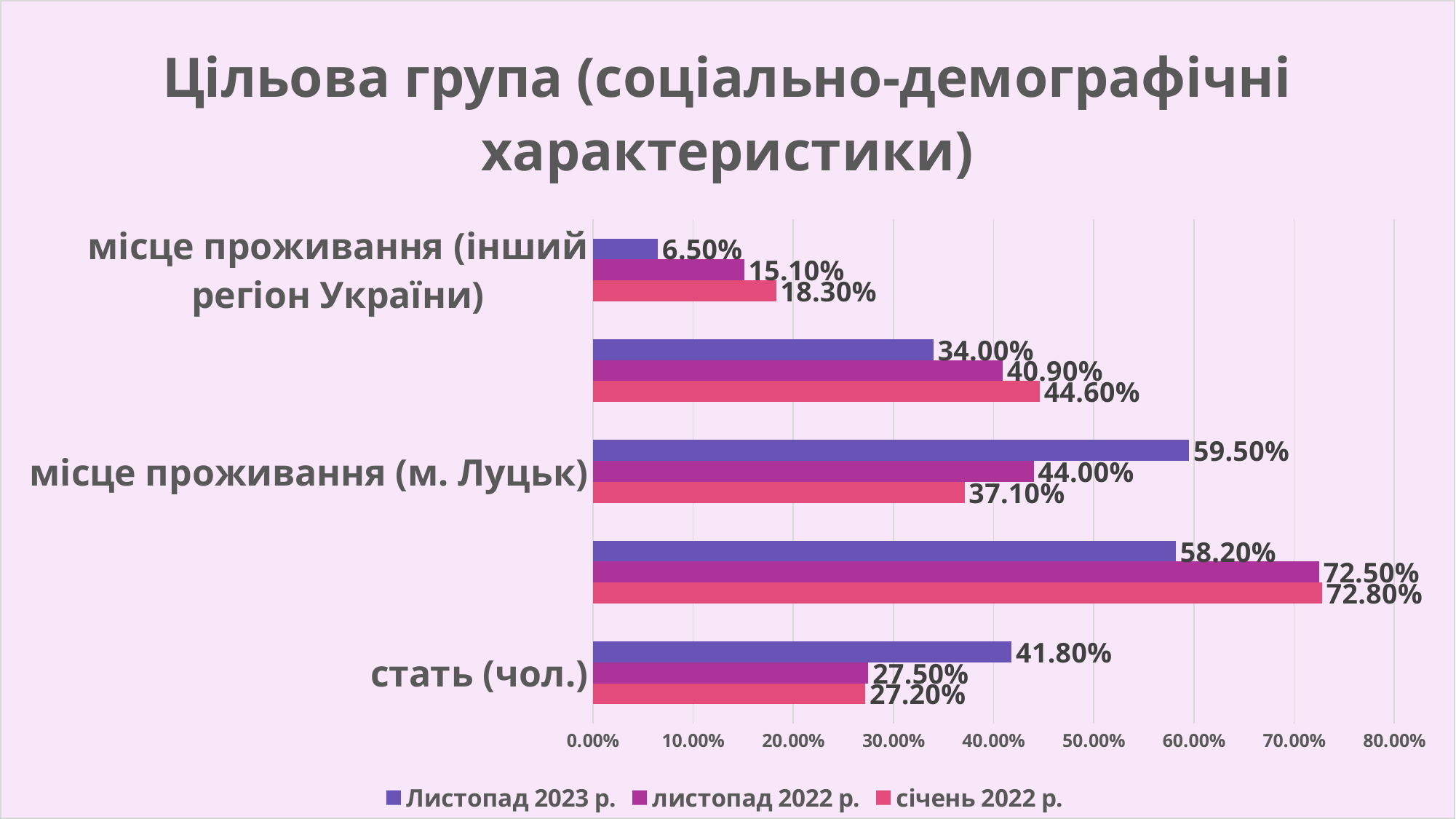
What is the value for 'стать (чол.)' in the 'Листопад 2023 р.' series? 41.80% Which category has the highest value in the 'Листопад 2023 р.' series? місце проживання (м. Луцьк) What is the value for 'місце проживання (інший регіон України)' in the 'листопад 2022 р.' series? 15.10% What is the value for 'стать (чол.)' in the 'січень 2022 р.' series? 27.20% How many categories (groups of bars) are plotted on the chart? 5 How many series does the legend list? 3 What is the difference between the 'Листопад 2023 р.' and 'січень 2022 р.' values for 'місце проживання (м. Луцьк)'? 22.40% What kind of chart is shown on the slide? bar chart Which category has the lowest value in the 'Листопад 2023 р.' series? місце проживання (інший регіон України) For 'стать (чол.)', which series has the larger value: 'Листопад 2023 р.' or 'листопад 2022 р.'? Листопад 2023 р. What is the difference between the 'січень 2022 р.' and 'Листопад 2023 р.' values for 'місце проживання (інший регіон України)'? 11.80% What is the value for 'місце проживання (м. Луцьк)' in the 'Листопад 2023 р.' series? 59.50%